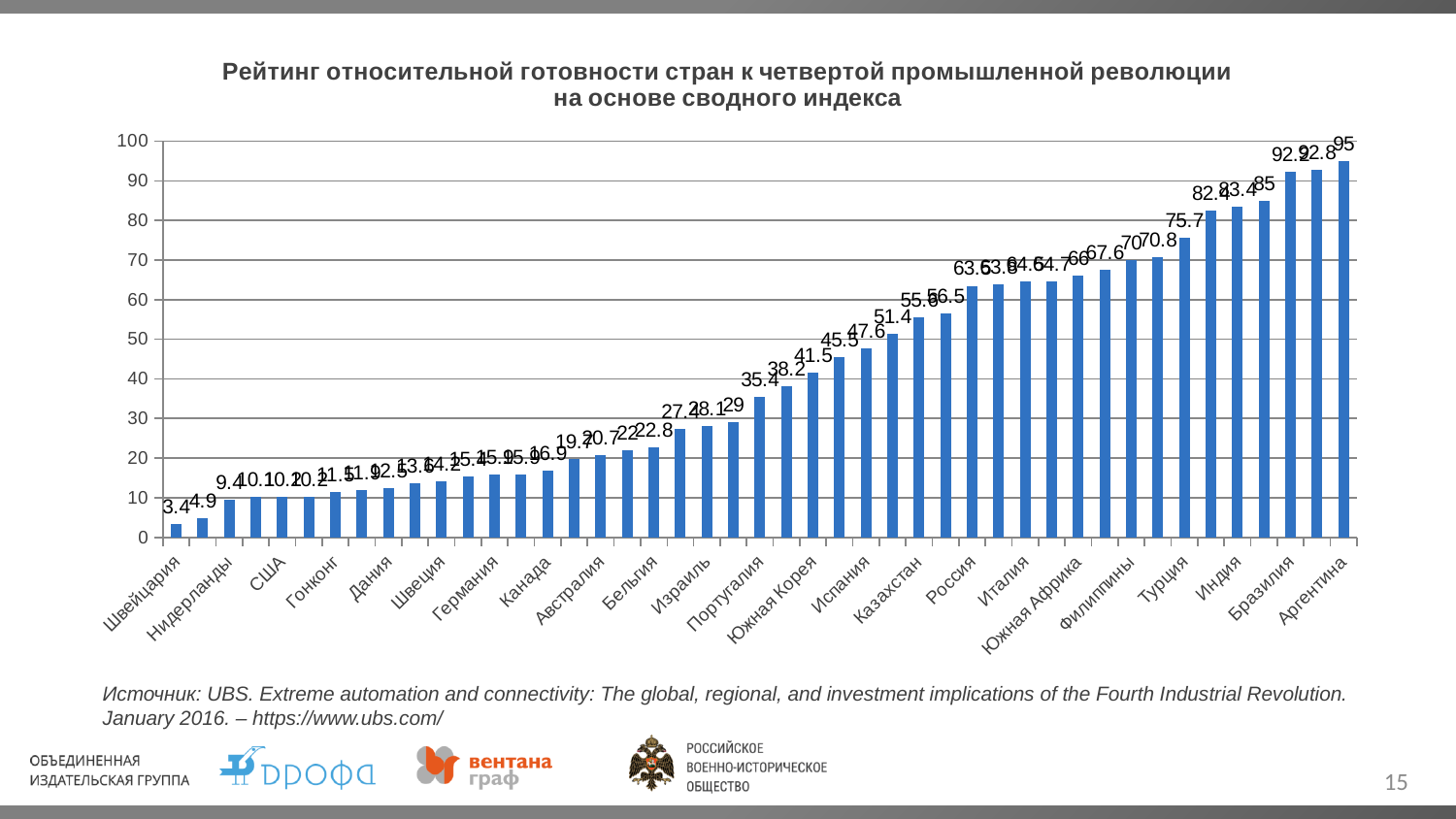
What is the difference between the values for Аргентина and Швейцария? 91.6 What is the value for Аргентина? 95 Which country has the highest value in the chart? Аргентина Is the value for Россия greater or less than 60? greater Do the values rise or fall from left to right along the x axis? rise What is the value for Швейцария? 3.4 Which has a larger value, Россия or Швеция? Россия What is the maximum value shown on the vertical axis? 100 Is the value for Португалия greater or less than 40? less Which country has the lowest value in the chart? Швейцария Is the value for Индия greater or less than 80? greater What type of chart is shown on the slide? bar chart